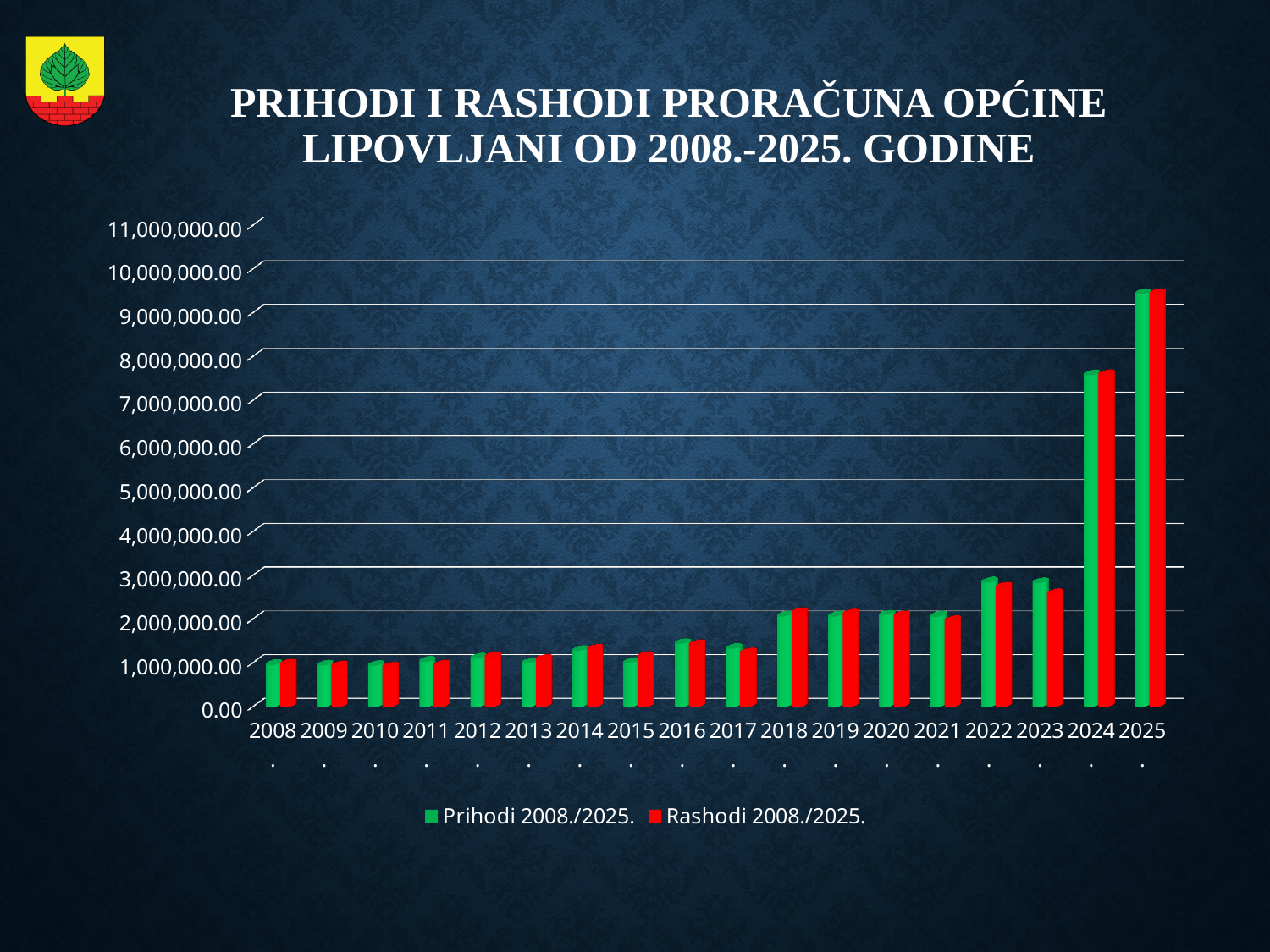
Is the value for Prihodi 2008./2025. in 2024 greater or less than 8,000,000.00? less What colour represents Rashodi 2008./2025. in the chart? Red Is the value for Prihodi 2008./2025. in 2016 greater or less than 2,000,000.00? less Do the values for Prihodi 2008./2025. generally rise or fall from 2008 to 2025? Rise Which year has the highest value for Prihodi 2008./2025.? 2025 Is the value for Prihodi 2008./2025. in 2025 greater or less than 9,000,000.00? greater How many series does the legend list? 2 Which is larger in 2023: Prihodi 2008./2025. or Rashodi 2008./2025.? Prihodi 2008./2025. How many years are shown on the x axis? 18 What kind of chart is shown on the slide? Bar chart